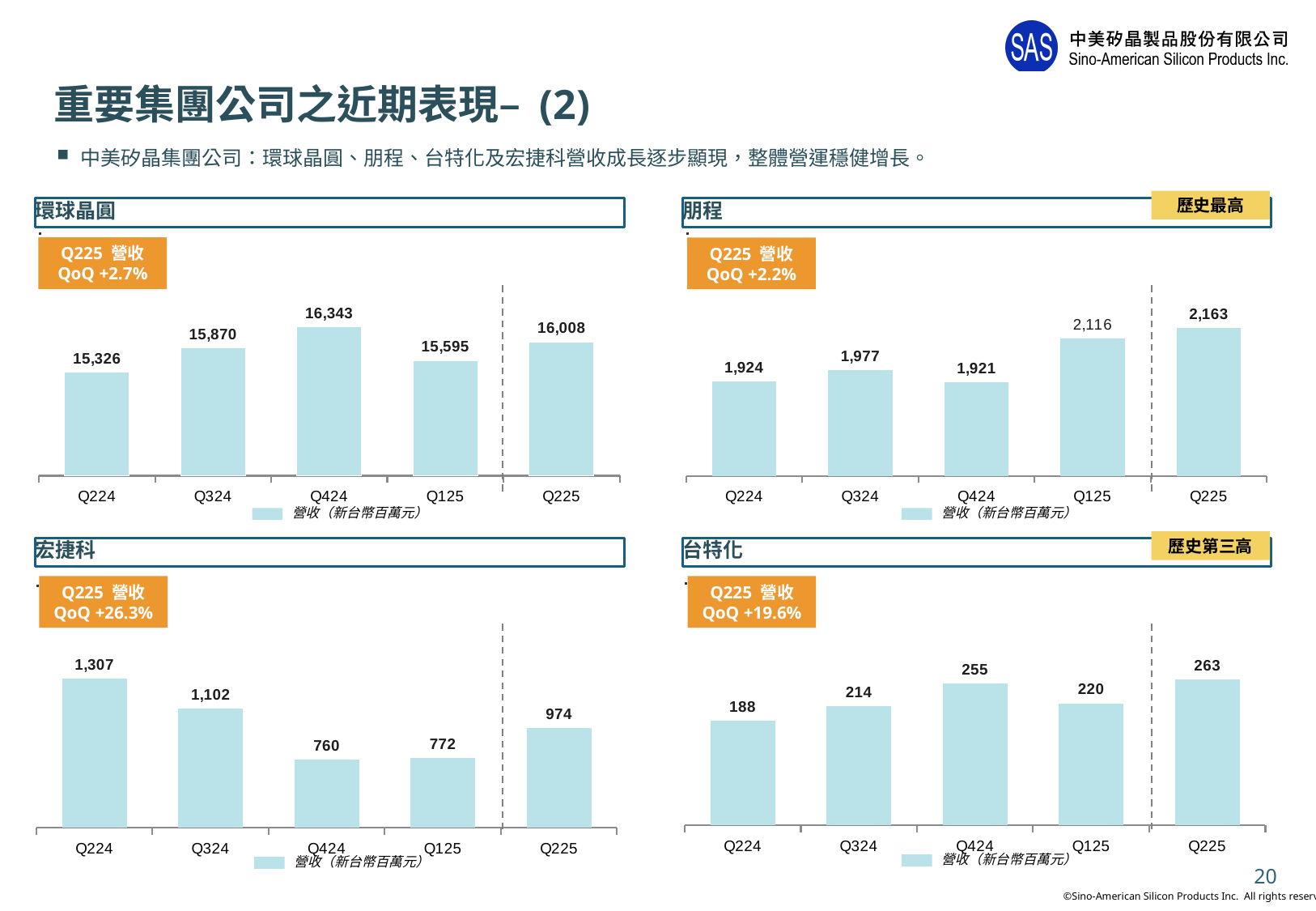
In the 台特化 chart, what is the difference between the Q225 and Q224 values? 75 In the 朋程 chart, what is the difference between the Q225 and Q125 values? 47 What kind of chart is used for 環球晶圓? Bar chart How many quarters are shown on the x axis of the 台特化 chart? 5 In the 宏捷科 chart, which quarter has the lowest revenue? Q424 In the 環球晶圓 chart, what is the revenue value for Q424? 16,343 In the 環球晶圓 chart, which quarter has the lowest revenue? Q224 In the 台特化 chart, what is the revenue value for Q424? 255 In the 朋程 chart, what is the revenue value for Q225? 2,163 In the 朋程 chart, which quarter has the highest revenue? Q225 In the 宏捷科 chart, is the value for Q324 larger or the value for Q225? Q324 In the 宏捷科 chart, what is the revenue value for Q224? 1,307